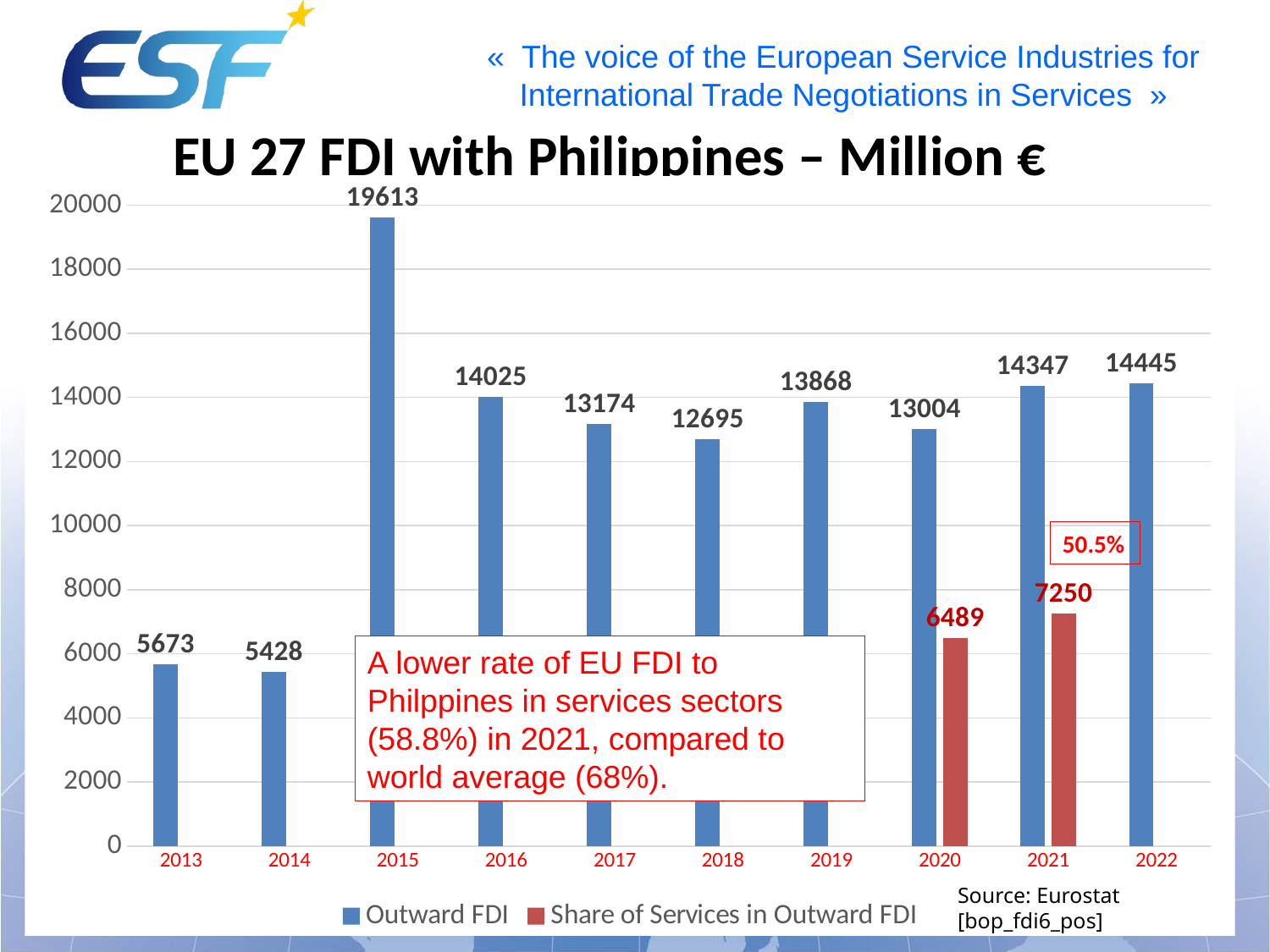
What is the Share of Services in Outward FDI value for 2021? 7250 Which year has the highest Outward FDI value? 2015 How many years are shown on the x axis? 10 What is the title of the chart? EU 27 FDI with Philippines – Million € What kind of chart is shown on the slide? bar chart Which is larger, the Outward FDI value for 2019 or for 2018? 2019 What is the difference between the Outward FDI values for 2022 and 2021? 98 What is the difference between the Share of Services in Outward FDI values for 2021 and 2020? 761 What is the Outward FDI value for 2015? 19613 Which year has the lowest Outward FDI value? 2014 Is the Outward FDI value for 2013 greater or less than 6000? less How many series does the legend list? 2